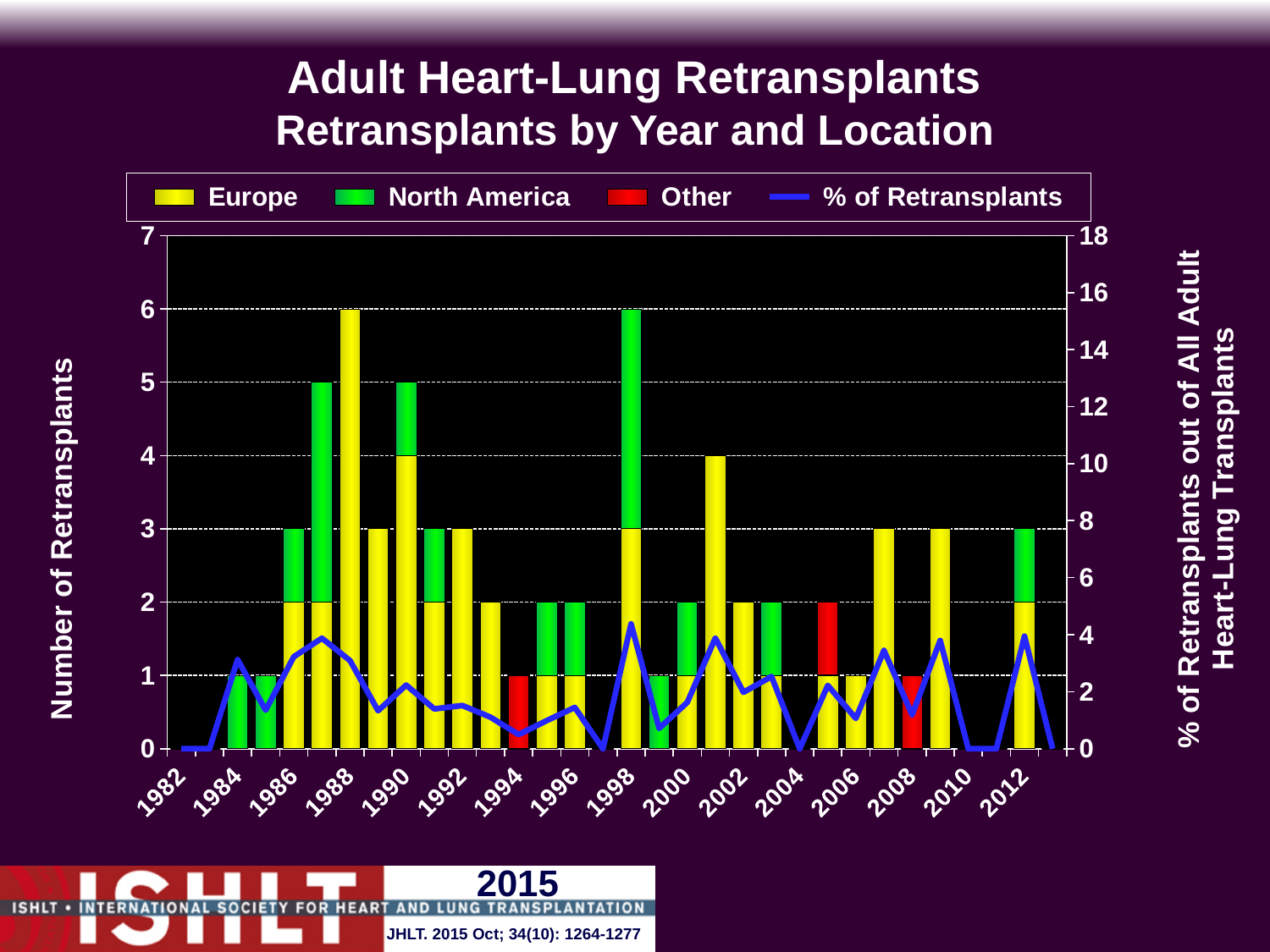
What is the total number of retransplants in 1988? 6 What is the highest total number of retransplants reached in any year? 6 How many retransplants were performed in Europe in 1990? 4 Which year has more total retransplants, 1988 or 1990? 1988 How many series does the legend list? 4 Is the % of Retransplants value for 1988 greater or less than 2? greater What is the total number of retransplants in 1998? 6 What is the difference in total retransplants between 1988 and 1992? 3 Which colour represents Europe in the legend? Yellow What kind of chart is shown on the slide? Stacked bar chart with a line What is the total number of retransplants in 1992? 3 Which location accounts for the single retransplant in 1994? Other